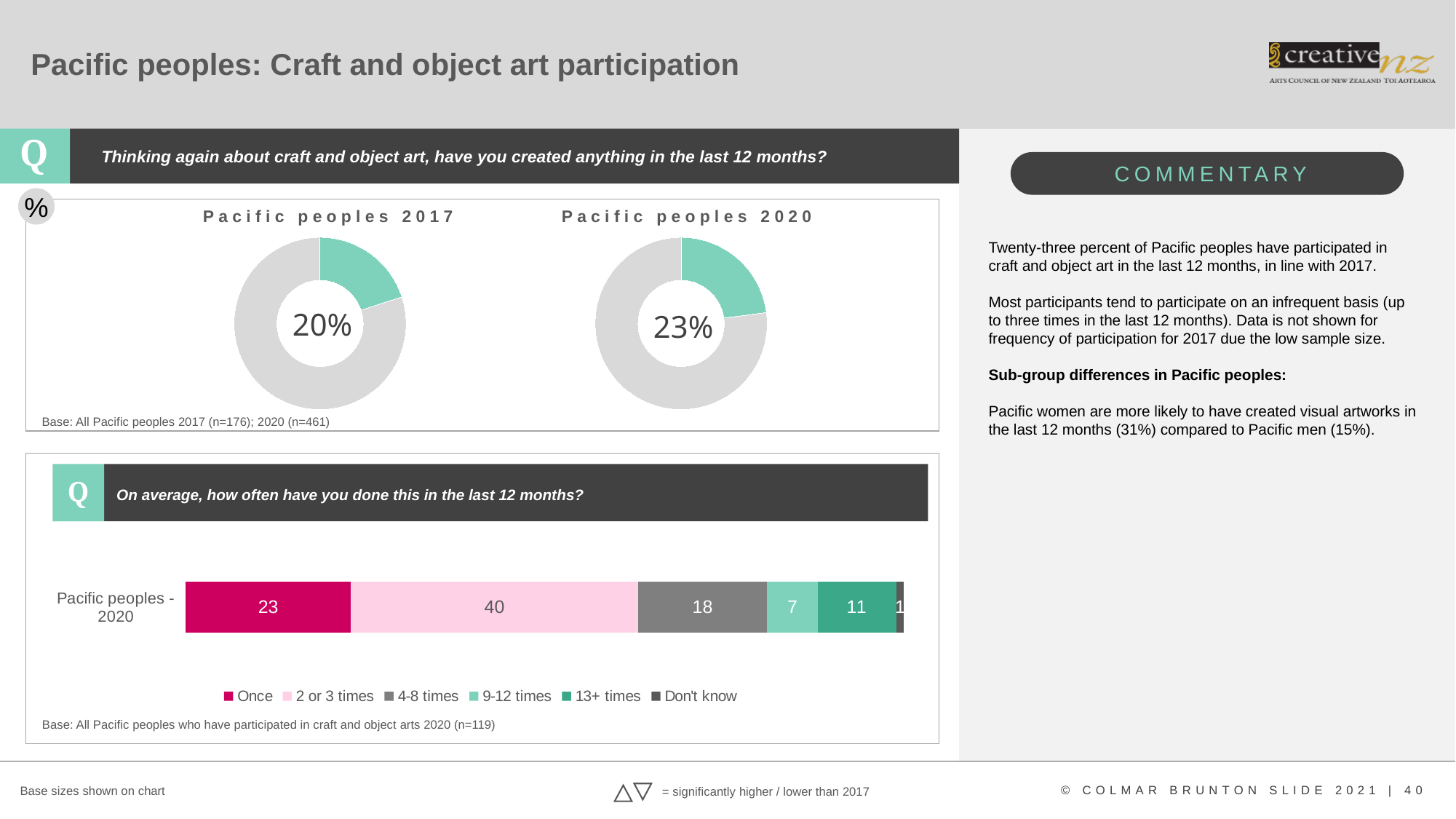
In the stacked bar chart at the bottom of the slide, what is the difference between the values for '4-8 times' and '9-12 times'? 11 In the stacked bar chart at the bottom of the slide, how many series does the legend list? 6 In the stacked bar chart for 'On average, how often have you done this in the last 12 months?', what is the value for 'Once'? 23 What is the difference between the percentages shown in the 'Pacific peoples 2020' and 'Pacific peoples 2017' donut charts? 3 percentage points In the 'Pacific peoples 2017' donut chart, what percentage is shown in the centre? 20% In the 'Pacific peoples 2020' donut chart, what percentage is shown in the centre? 23% What type of chart is used for 'Pacific peoples 2017' and 'Pacific peoples 2020'? Donut chart In the stacked bar chart at the bottom of the slide, which frequency category has the largest value? 2 or 3 times In the stacked bar chart at the bottom of the slide, what is the value for '2 or 3 times'? 40 In the stacked bar chart at the bottom of the slide, which frequency category has the smallest value? Don't know In the stacked bar chart at the bottom of the slide, what is the value for '13+ times'? 11 Comparing the two donut charts, which year shows the higher participation percentage, 2017 or 2020? 2020